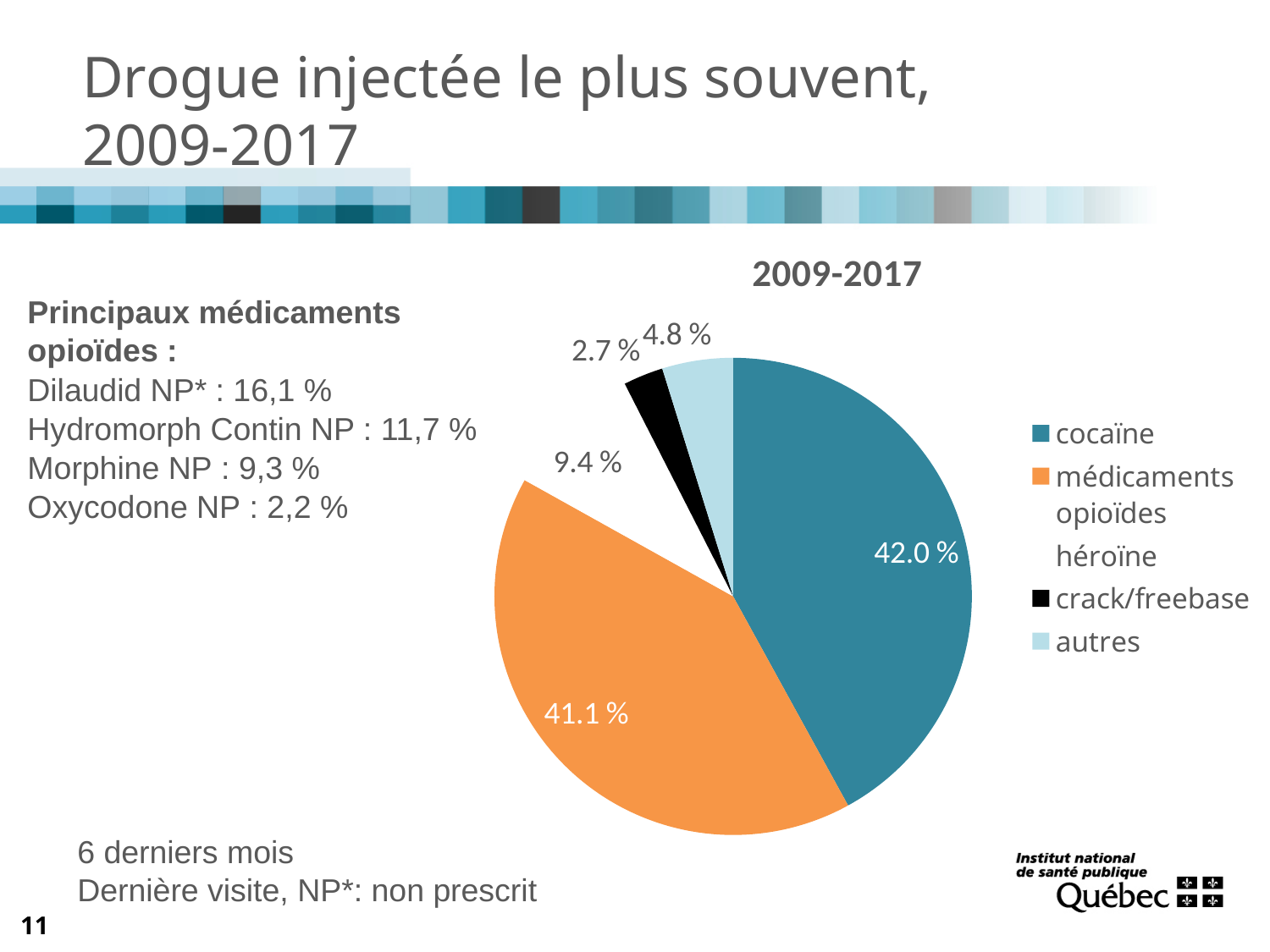
What share of the pie is autres? 4.8 % What share of the pie is médicaments opioïdes? 41.1 % What share of the pie is cocaïne? 42.0 % What is the chart's title? 2009-2017 Which category has the smallest slice of the pie? crack/freebase What share of the pie is crack/freebase? 2.7 % What type of chart is shown on the slide? pie chart Which category has the largest slice of the pie? cocaïne What is the difference in percentage points between the cocaïne slice and the héroïne slice? 32.6 What share of the pie is héroïne? 9.4 % Which is larger, the slice for autres or the slice for crack/freebase? autres How many categories does the legend list? 5